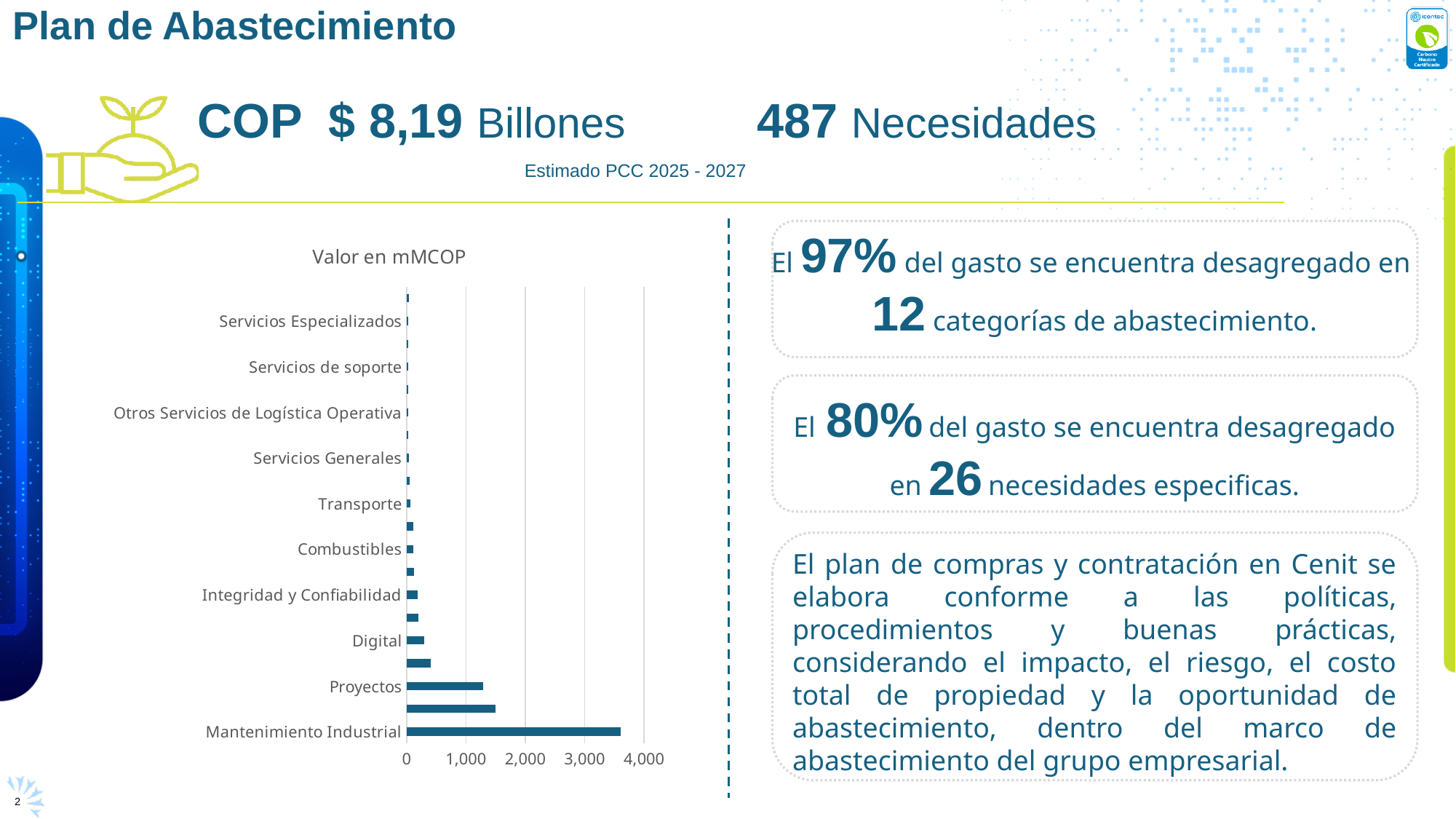
Which has a larger value, Proyectos or Digital? Proyectos What kind of chart is shown on the slide? bar chart Is the value for Digital greater or less than 1,000? less What is the highest value shown on the horizontal axis of the chart? 4,000 Is the value for Mantenimiento Industrial greater or less than 4,000? less Is the value for Proyectos greater or less than 2,000? less Which has a larger value, Mantenimiento Industrial or Proyectos? Mantenimiento Industrial What is the title of the chart? Valor en mMCOP Which category has the highest value in the chart? Mantenimiento Industrial